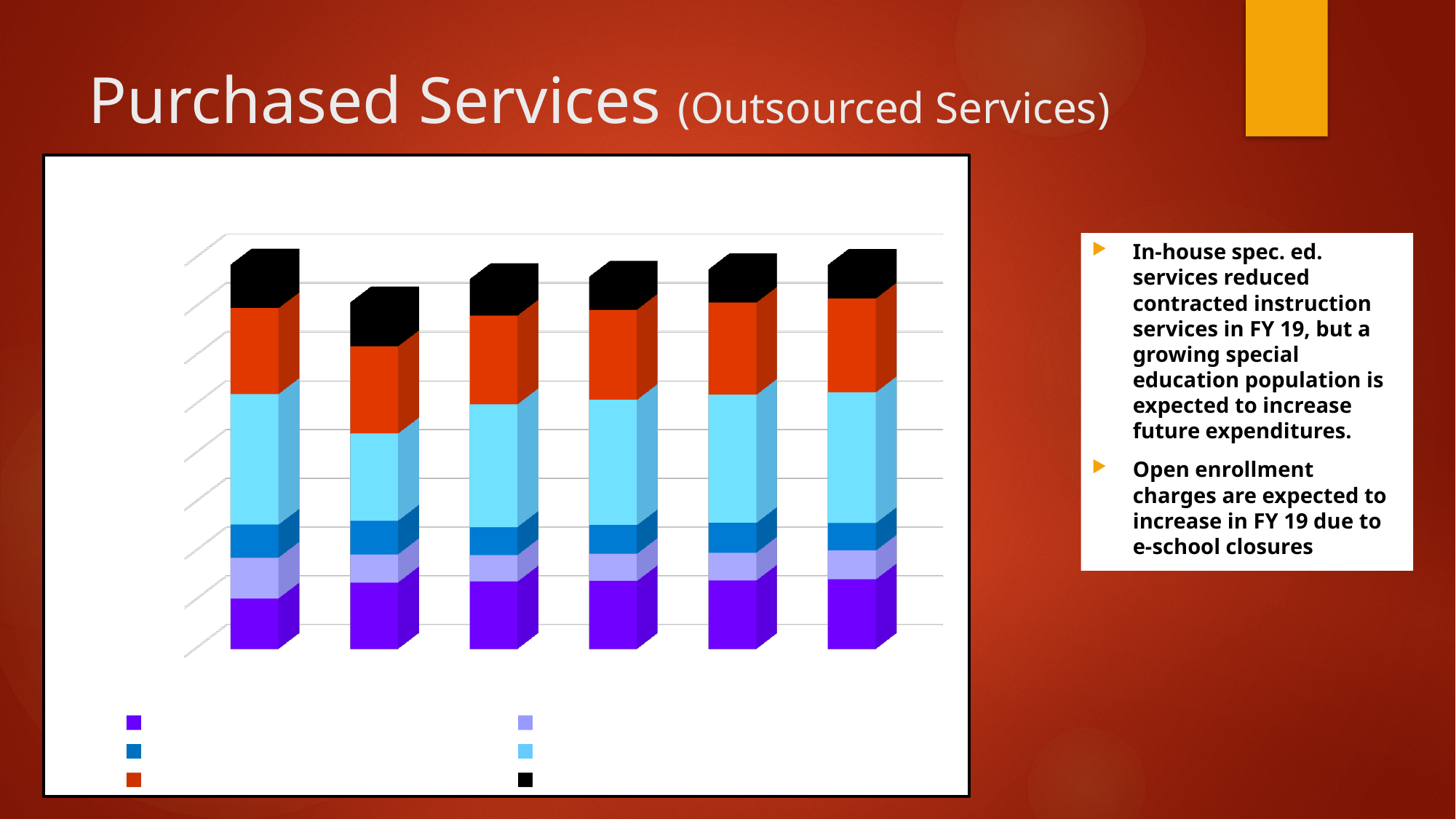
Counting from the left, which bar is the shortest in total height? the second bar How many bars are plotted in the chart? 6 Is the second bar from the left taller or shorter than the third bar from the left? shorter What colour is the topmost segment of each stacked bar? black What kind of chart is shown on the slide? stacked bar chart How many series does the chart's legend list? 6